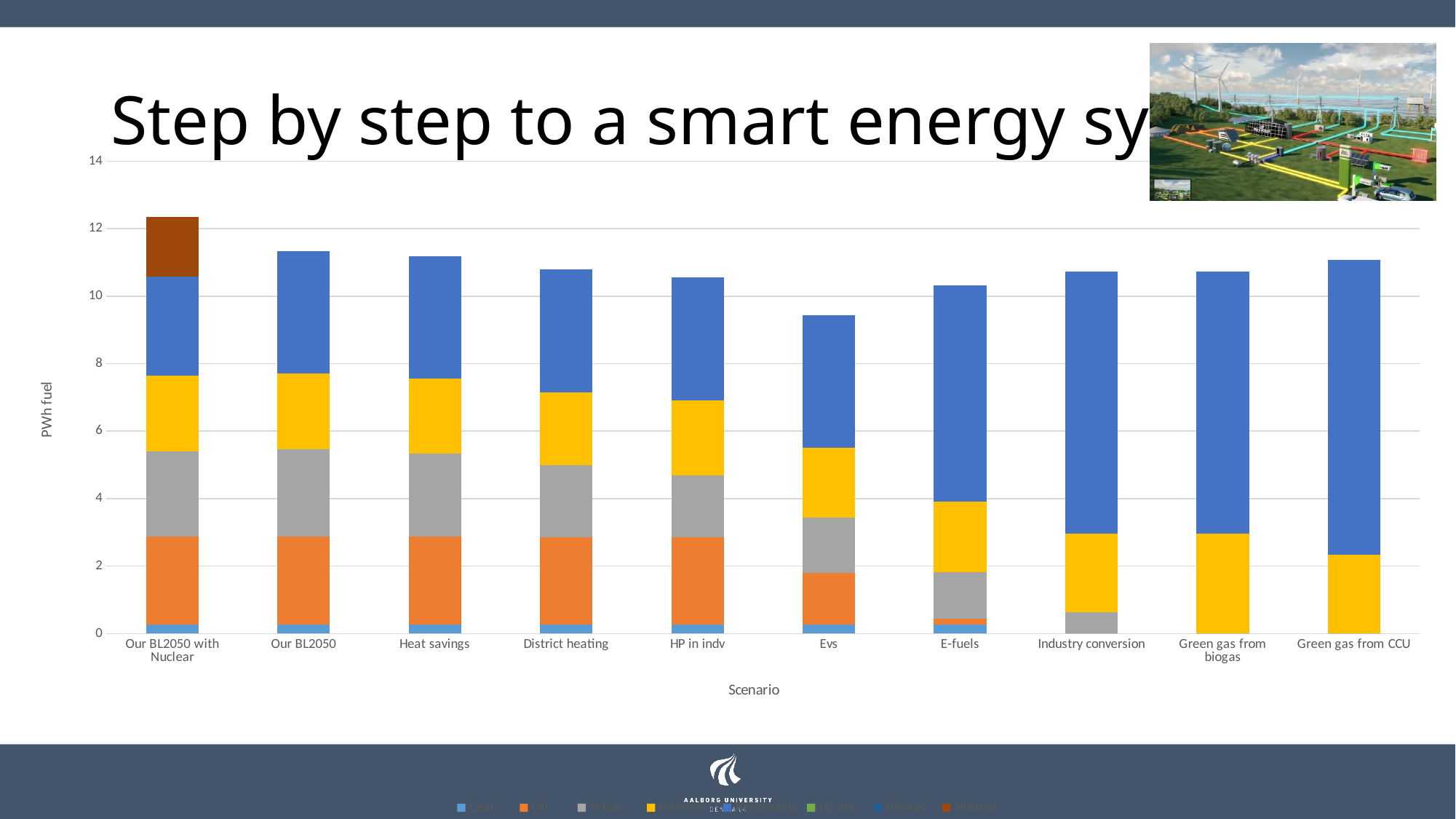
Which scenario has the lowest total bar in the chart? Evs Is the total bar for Industry conversion greater or less than 12? less Which has the larger total bar, Evs or E-fuels? E-fuels Which scenario has the highest total bar in the chart? Our BL2050 with Nuclear Is the total bar for Evs greater or less than 10? less What kind of chart is shown on the slide? Stacked bar chart Is the total bar for Our BL2050 with Nuclear greater or less than 12? greater What is the label of the vertical axis of the chart? PWh fuel What is the label of the horizontal axis of the chart? Scenario How many scenarios are shown on the x axis of the chart? 10 Which has the larger total bar, Our BL2050 or Evs? Our BL2050